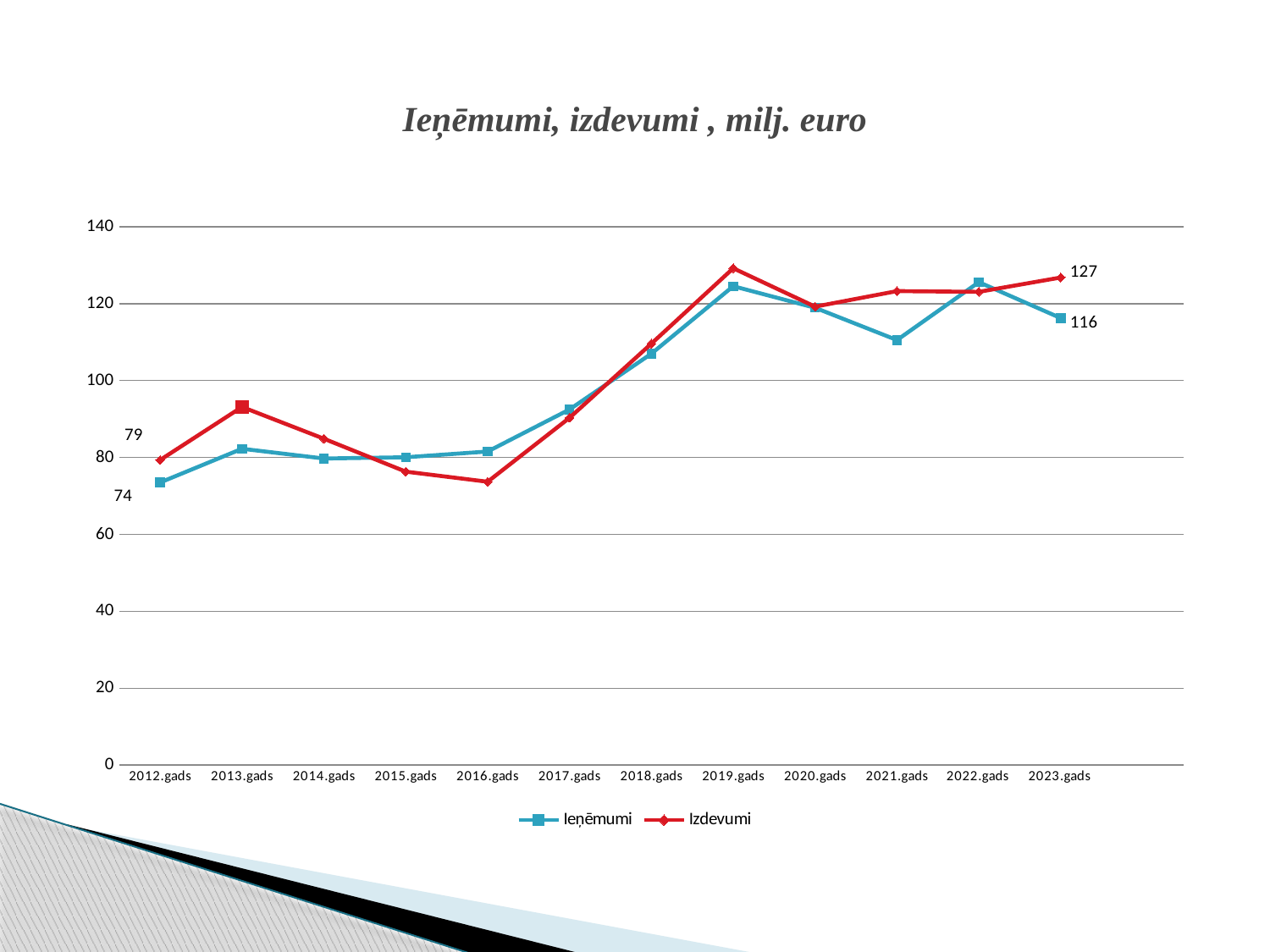
In 2023.gads, which is larger, Ieņēmumi or Izdevumi? Izdevumi What is the value of Izdevumi for 2023.gads? 127 In which year is Ieņēmumi lowest? 2012.gads What kind of chart is shown on the slide? line chart What is the value of Ieņēmumi for 2023.gads? 116 What is the difference between Izdevumi and Ieņēmumi in 2023.gads? 11 What is the value of Ieņēmumi for 2012.gads? 74 How many series does the legend list? 2 Is the value of Izdevumi for 2019.gads greater or less than 120? greater What is the value of Izdevumi for 2012.gads? 79 By how much did Ieņēmumi increase from 2012.gads to 2023.gads? 42 How many years are shown on the x axis? 12